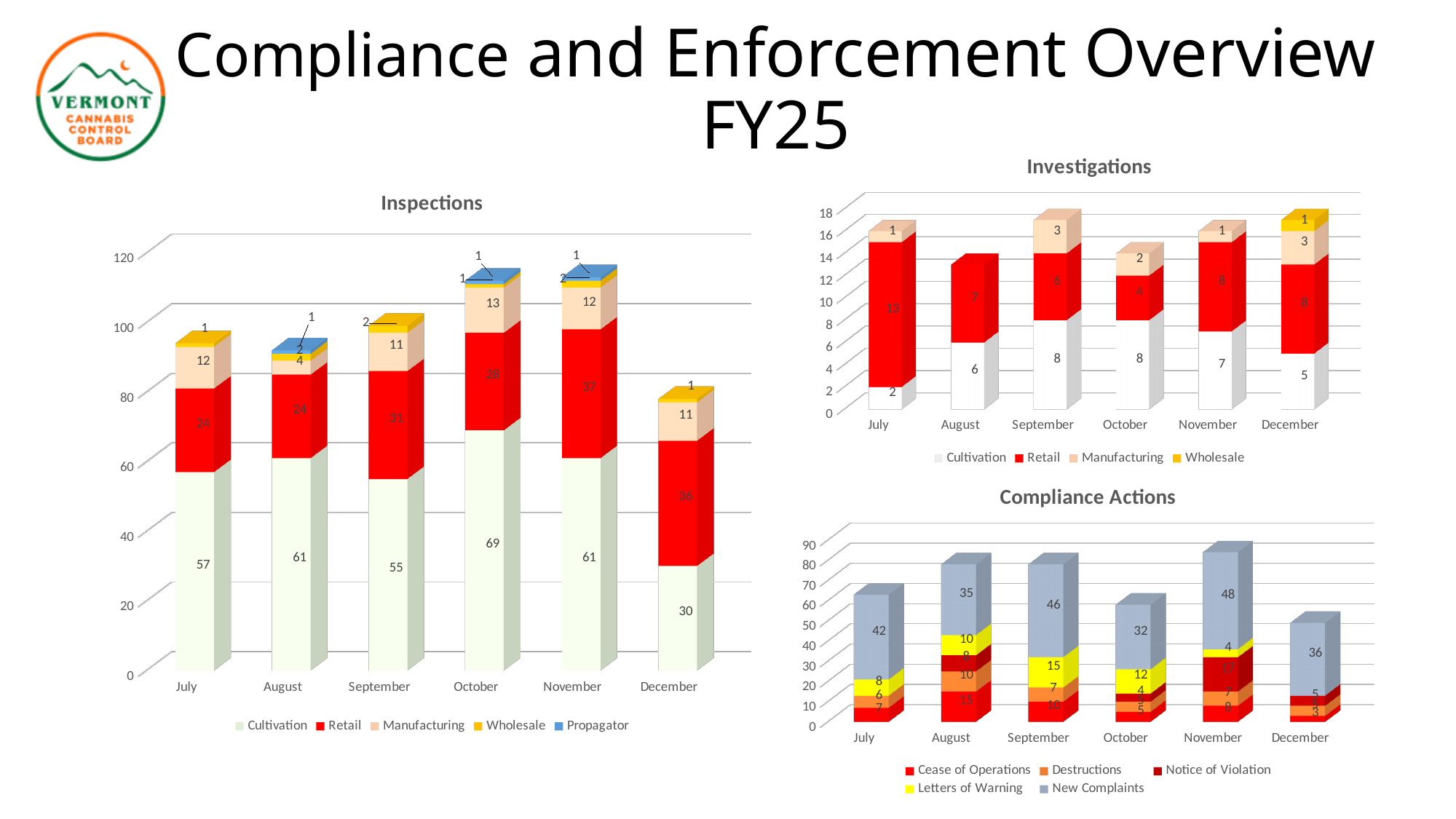
In the Inspections chart, which month has the highest Cultivation value? October In the Inspections chart, which month has the lowest Cultivation value? December In the Compliance Actions chart, what is the New Complaints value for November? 48 In the Inspections chart, what is the difference between the Retail value for December and the Retail value for July? 12 In the Investigations chart, what is the total of the stacked bar for July? 16 What kind of chart is the Compliance Actions chart? Stacked bar chart In the Inspections chart, what is the Retail value for November? 37 How many series does the legend of the Inspections chart list? 5 In the Investigations chart, what is the Retail value for July? 13 In the Investigations chart, which month has the lowest Cultivation value? July In the Inspections chart, what is the Cultivation value for October? 69 In the Compliance Actions chart, which month has the highest New Complaints value? November